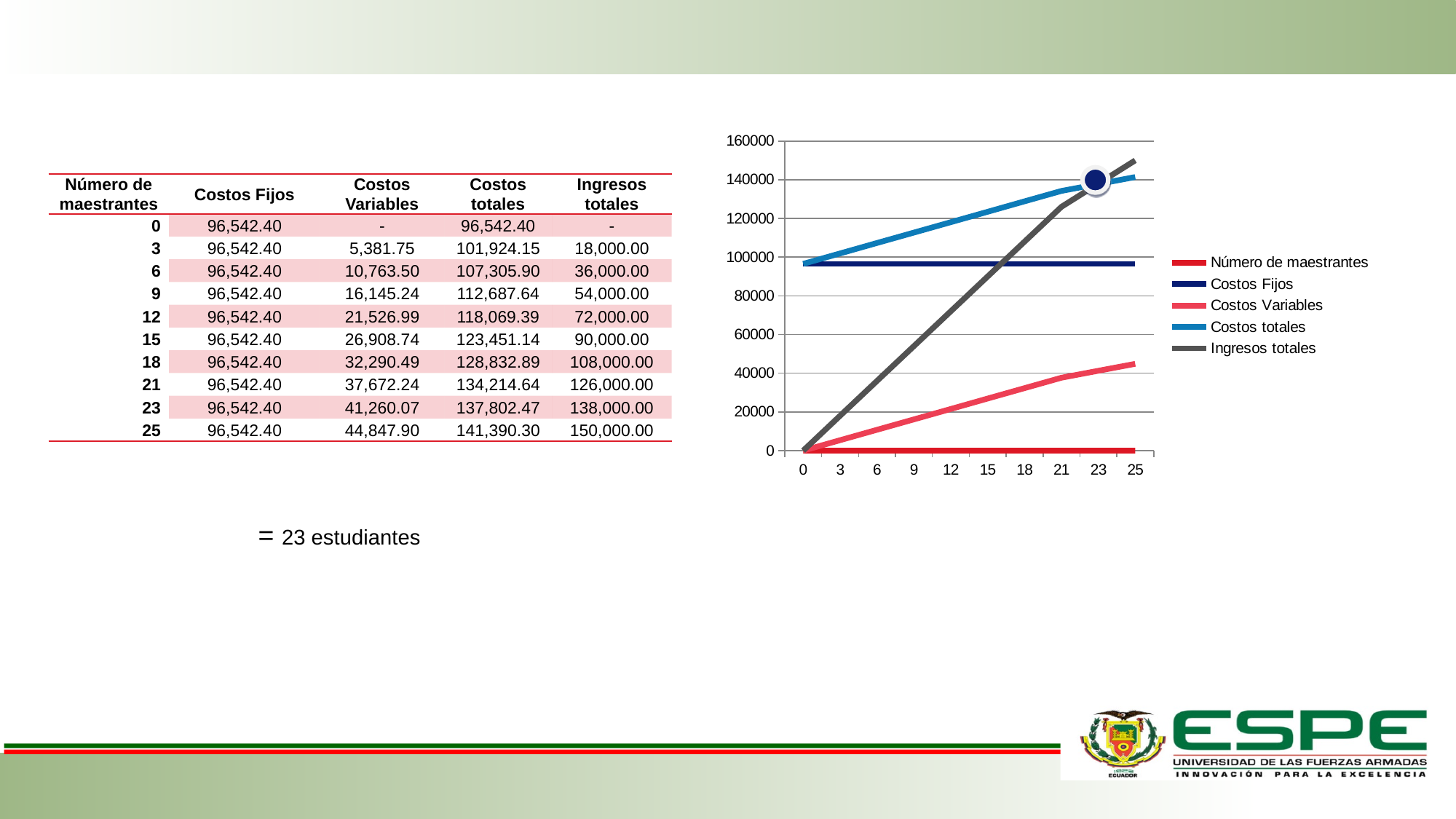
Does the Ingresos totales line rise or fall as the number of maestrantes increases? rises Does the Costos Fijos line rise, fall or stay flat along the x axis? stays flat Which series is drawn in dark grey in the chart? Ingresos totales How many series does the chart legend list? 5 According to the table, what is the value of Costos totales for 23 maestrantes? 137,802.47 At 0 maestrantes, which is larger: Costos totales or Ingresos totales? Costos totales At 25 maestrantes, which is larger: Ingresos totales or Costos totales? Ingresos totales How many points are on the x axis of the chart? 10 Is the value of Ingresos totales at 25 maestrantes greater or less than 140000? greater Is the value of Costos Variables at 25 maestrantes greater or less than 60000? less Is the value of Costos totales at 0 maestrantes greater or less than 80000? greater What kind of chart is shown on the slide? line chart